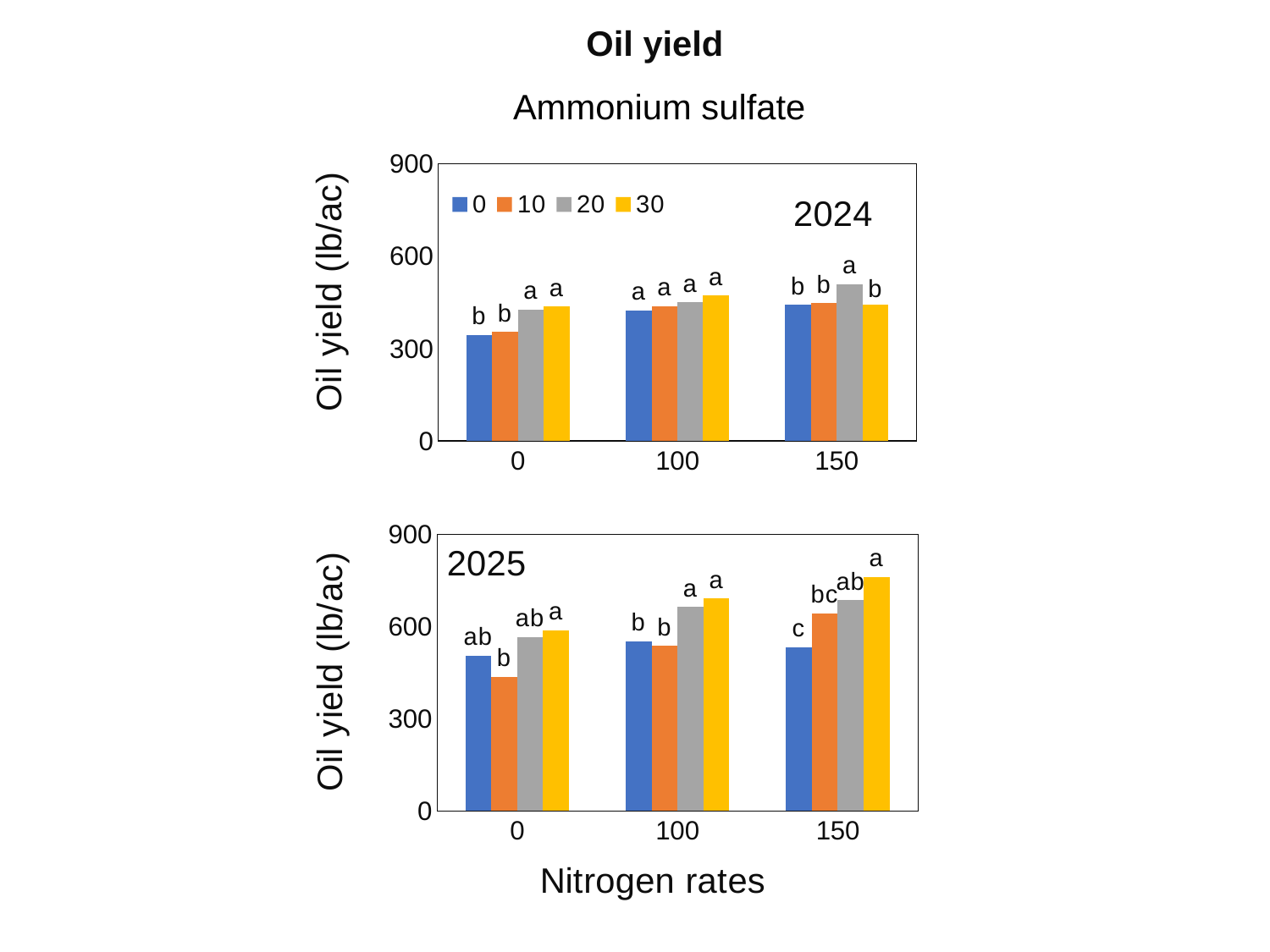
What is the y-axis label of the 2025 chart? Oil yield (lb/ac) How many nitrogen rate categories are shown on the x axis of the 2025 chart? 3 What is the x-axis label shown below the 2025 chart? Nitrogen rates In the 2024 chart, which series has the highest bar at nitrogen rate 150? 20 In the 2025 chart, which series has the highest bar at nitrogen rate 150? 30 How many series does the legend of the 2024 chart list? 4 In the 2025 chart, is the value for series 30 at nitrogen rate 150 greater or less than 600? greater In the 2025 chart, do the values for series 30 rise or fall as the nitrogen rate increases from 0 to 150? rise What kind of chart is the 2024 chart on the slide? bar chart In the 2025 chart, at nitrogen rate 100, which is larger: the bar for series 30 or the bar for series 0? 30 In the 2025 chart, which series has the lowest bar at nitrogen rate 0? 10 In the 2024 chart, is the value for series 0 at nitrogen rate 0 greater or less than 600? less